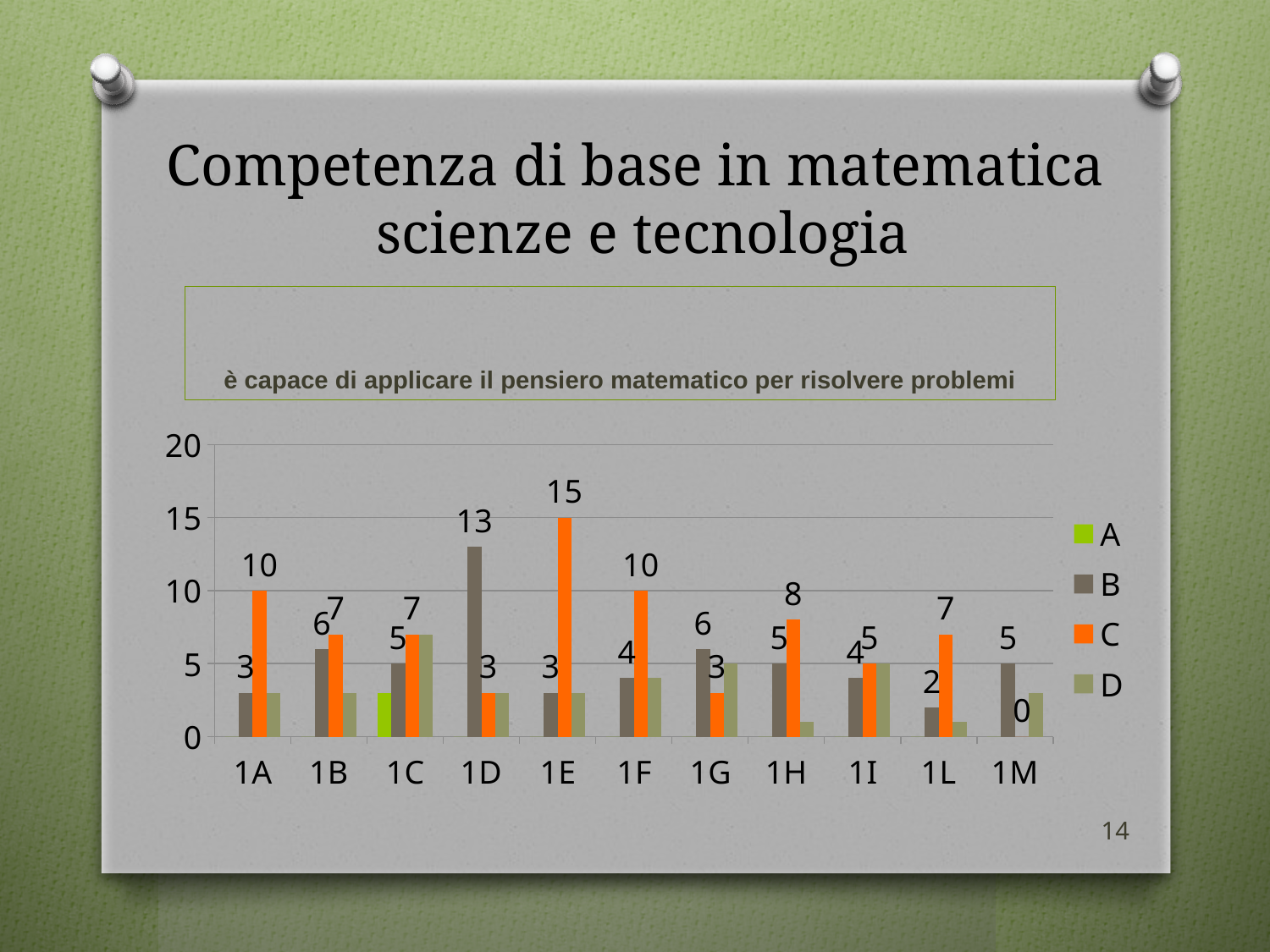
How many categories (classes) are shown on the x axis? 11 Which colour represents series C in the legend? orange For class 1A, which is larger: series B or series C? C What is the value of series B for class 1L? 2 Which class has the highest value for series C? 1E Is the value of series D for class 1H greater or less than 5? less What is the value of series C for class 1E? 15 What is the value of series B for class 1D? 13 Which class has the highest value for series B? 1D How many series does the legend list? 4 What is the difference between series C and series B for class 1E? 12 What kind of chart is shown on the slide? bar chart